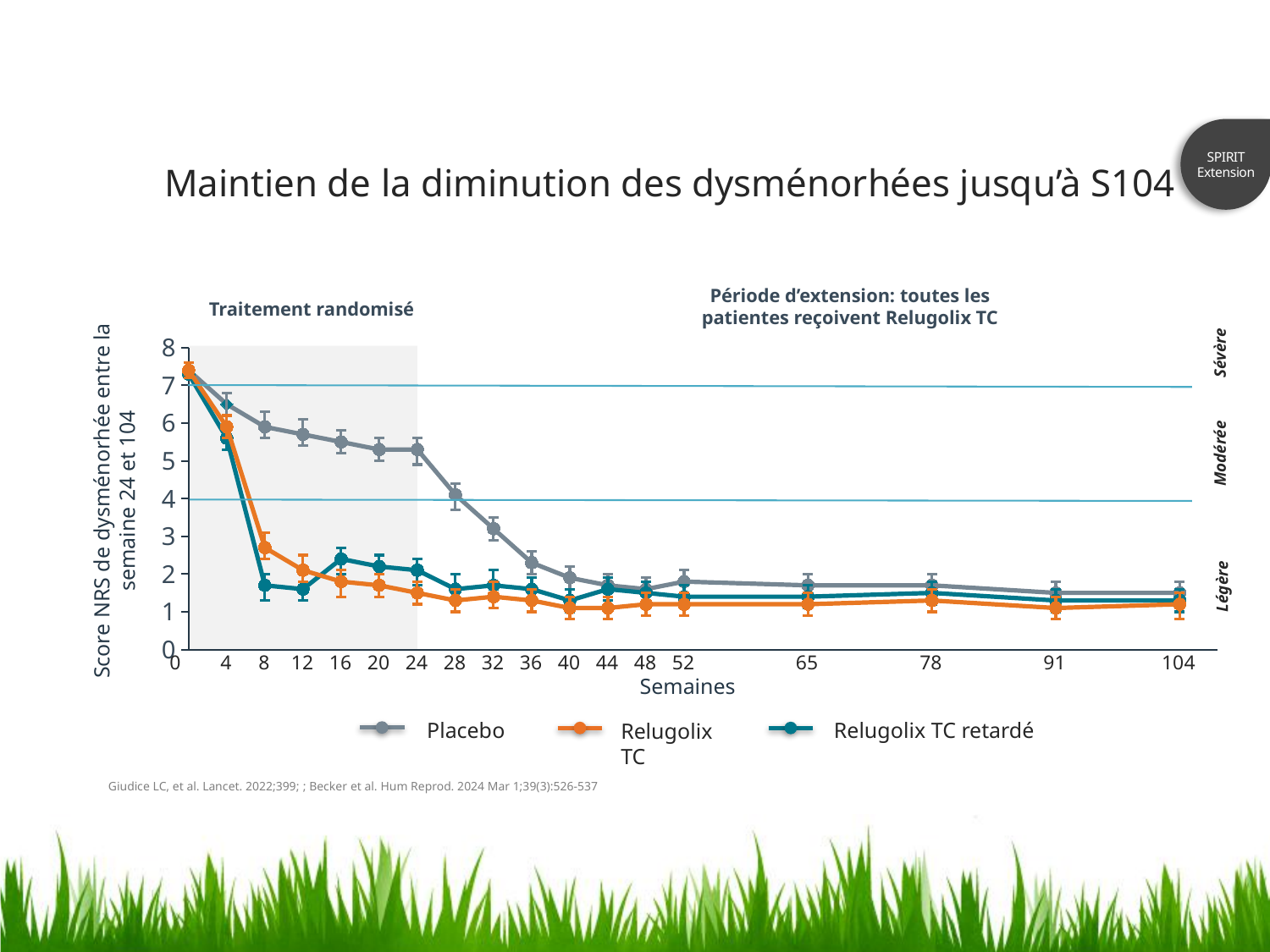
Is the value for Placebo at week 104 greater or less than 2? less Which series has the highest value at week 16? Placebo What kind of chart is shown on the slide? line chart Is the value for Placebo at week 24 greater or less than 4? greater Is the value for Placebo at week 32 greater or less than 4? less How many week values are labelled on the x axis? 18 What is the label of the x axis? Semaines How many series does the legend list? 3 At week 24, which series has the higher value: Placebo or Relugolix TC? Placebo Does the Placebo series rise or fall from week 0 to week 104? fall